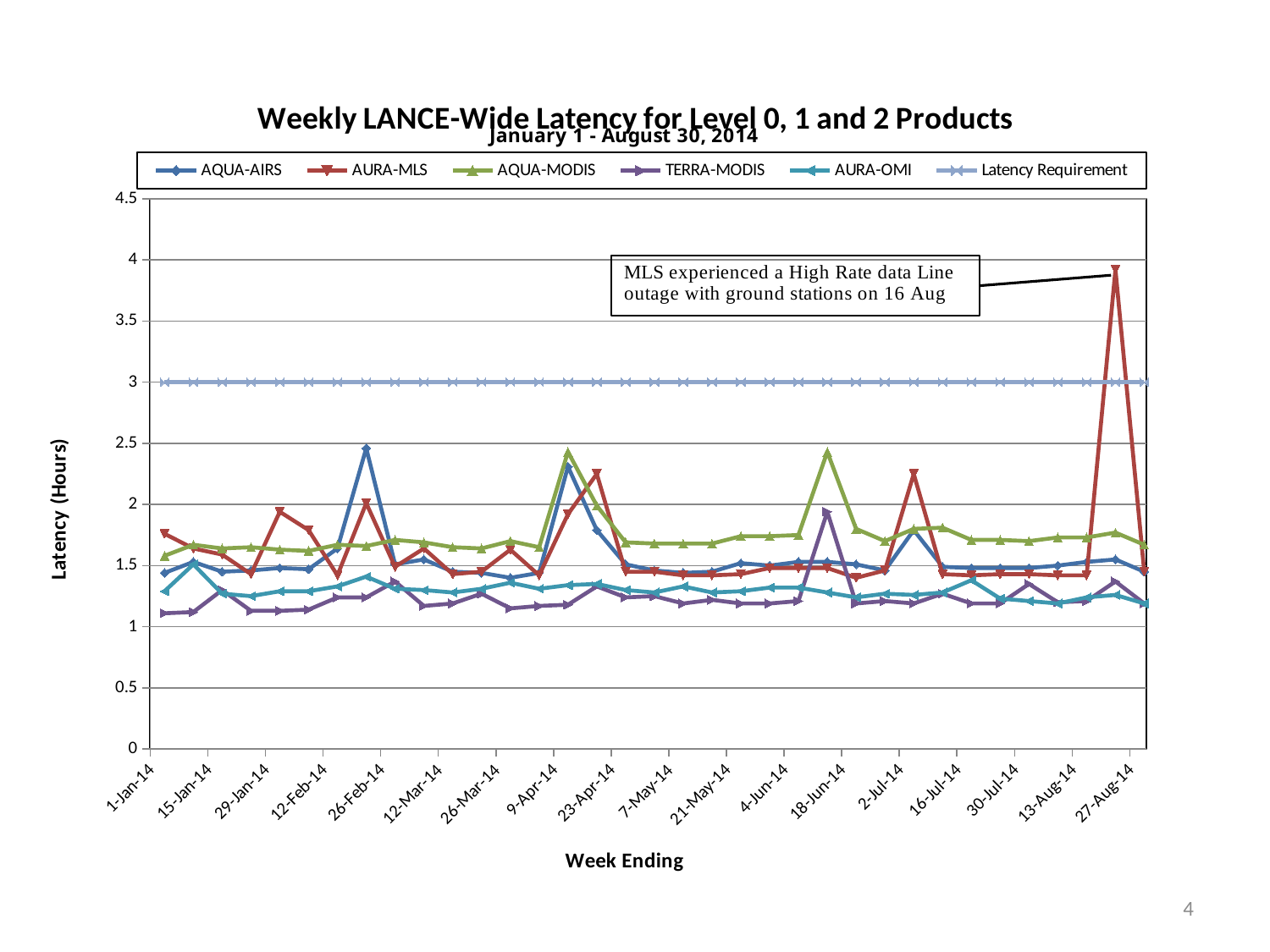
Which series has the lowest value at 1-Jan-14? TERRA-MODIS Is the value for TERRA-MODIS at 1-Jan-14 greater or less than 1.5? less Is the value for AQUA-AIRS at 26-Feb-14 greater or less than 2? greater At 26-Feb-14, which is larger: AQUA-AIRS or AURA-MLS? AQUA-AIRS At 18-Jun-14, which is larger: AQUA-MODIS or TERRA-MODIS? AQUA-MODIS What kind of chart is shown on the slide? line chart Does the Latency Requirement line rise, fall, or stay flat across the x axis? stays flat What is the label of the y axis? Latency (Hours) Is the peak value of the AURA-MLS series greater or less than 3.5? greater What value does the Latency Requirement line hold across the whole chart? 3 How many series does the legend list? 6 Which series reaches the highest value anywhere on the chart? AURA-MLS